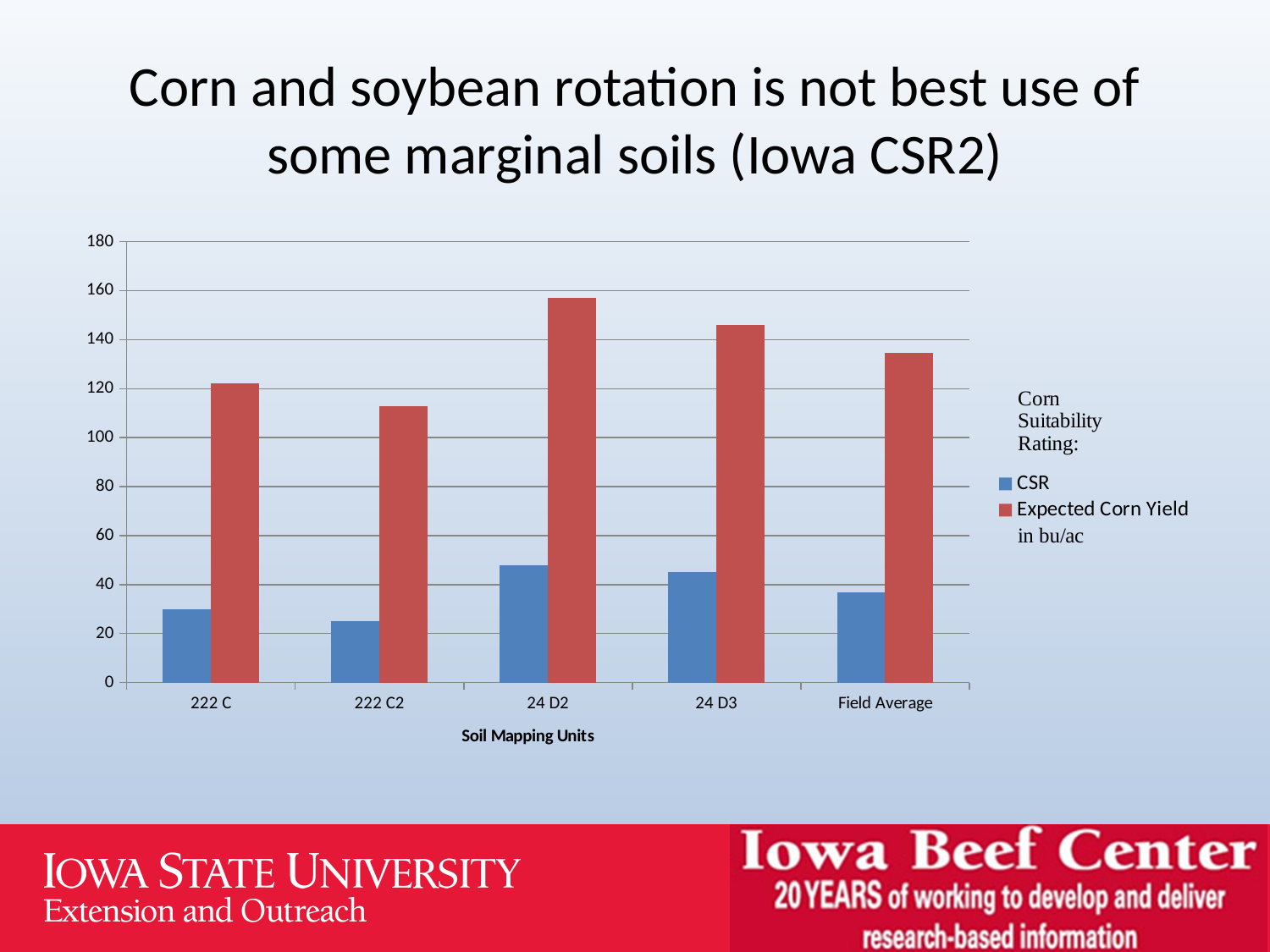
Is the CSR for 222 C2 greater or less than 40? less Which soil mapping unit has the lowest Expected Corn Yield in bu/ac? 222 C2 How many data series does the legend list? 2 Which soil mapping unit has the lowest CSR? 222 C2 Which has the higher Expected Corn Yield, 24 D2 or 24 D3? 24 D2 What kind of chart is shown on the slide? bar chart Is the Expected Corn Yield for 24 D2 greater or less than 140? greater Which soil mapping unit has the highest Expected Corn Yield in bu/ac? 24 D2 How many soil mapping unit categories are shown on the x axis? 5 What is the label of the x axis? Soil Mapping Units Which has the higher CSR, 222 C or 222 C2? 222 C Is the Expected Corn Yield for Field Average greater or less than 120? greater